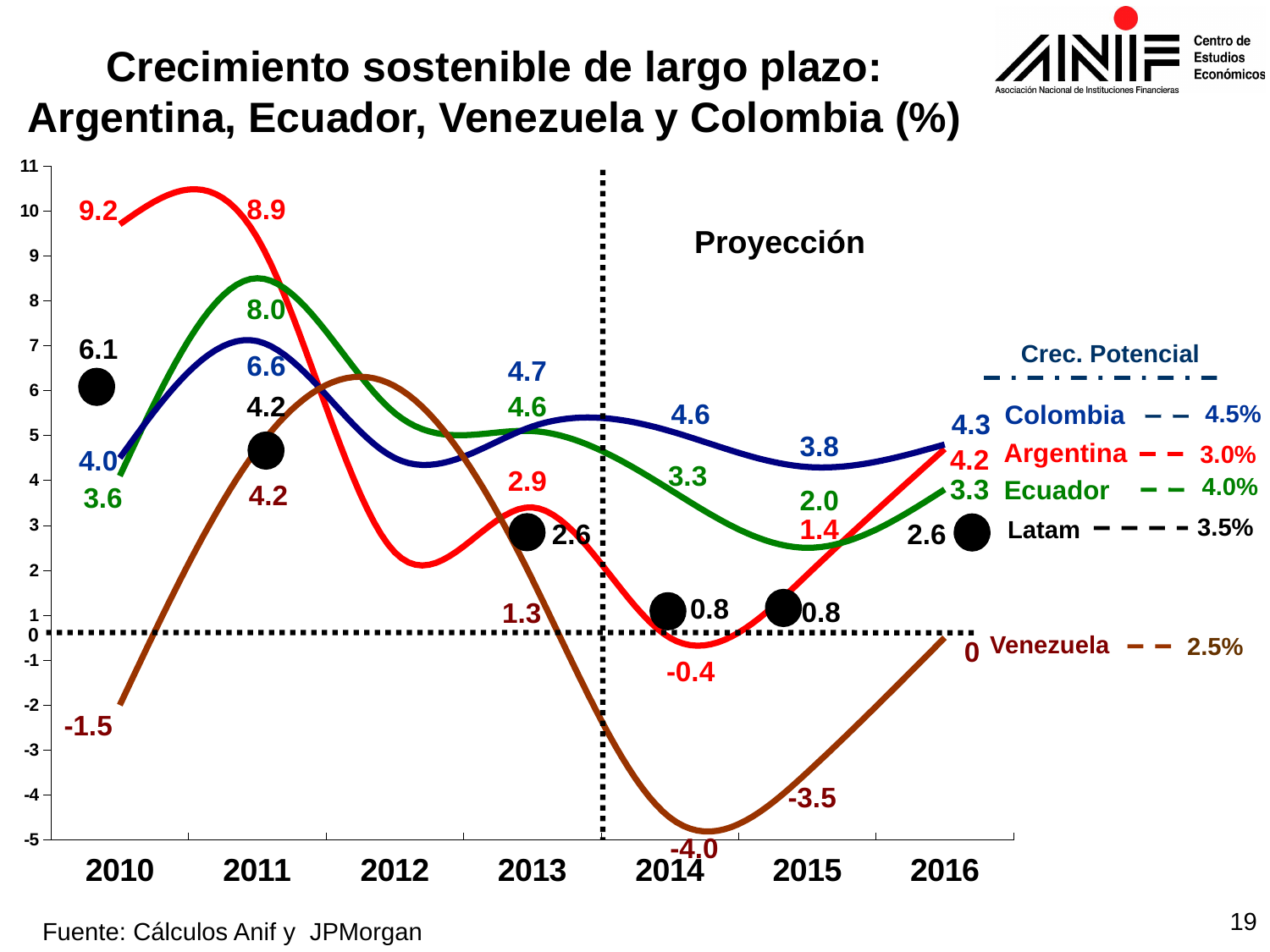
Which country has the highest growth value in 2011? Argentina Is the value for Venezuela in 2012 greater or less than 5? greater What is the growth value for Venezuela in 2014? -4.0 What is the growth value for Argentina in 2010? 9.2 What kind of chart is shown on the slide? line chart Which country has the lowest growth value in 2015? Venezuela By how much did Colombia's growth increase from 2010 to 2011? 2.6 What is the Latam value in 2013? 2.6 How many years are shown on the x axis? 7 How many series does the legend list? 5 In 2016, which is larger: the value for Colombia or the value for Ecuador? Colombia Does the Venezuela line rise or fall from 2014 to 2016? rise